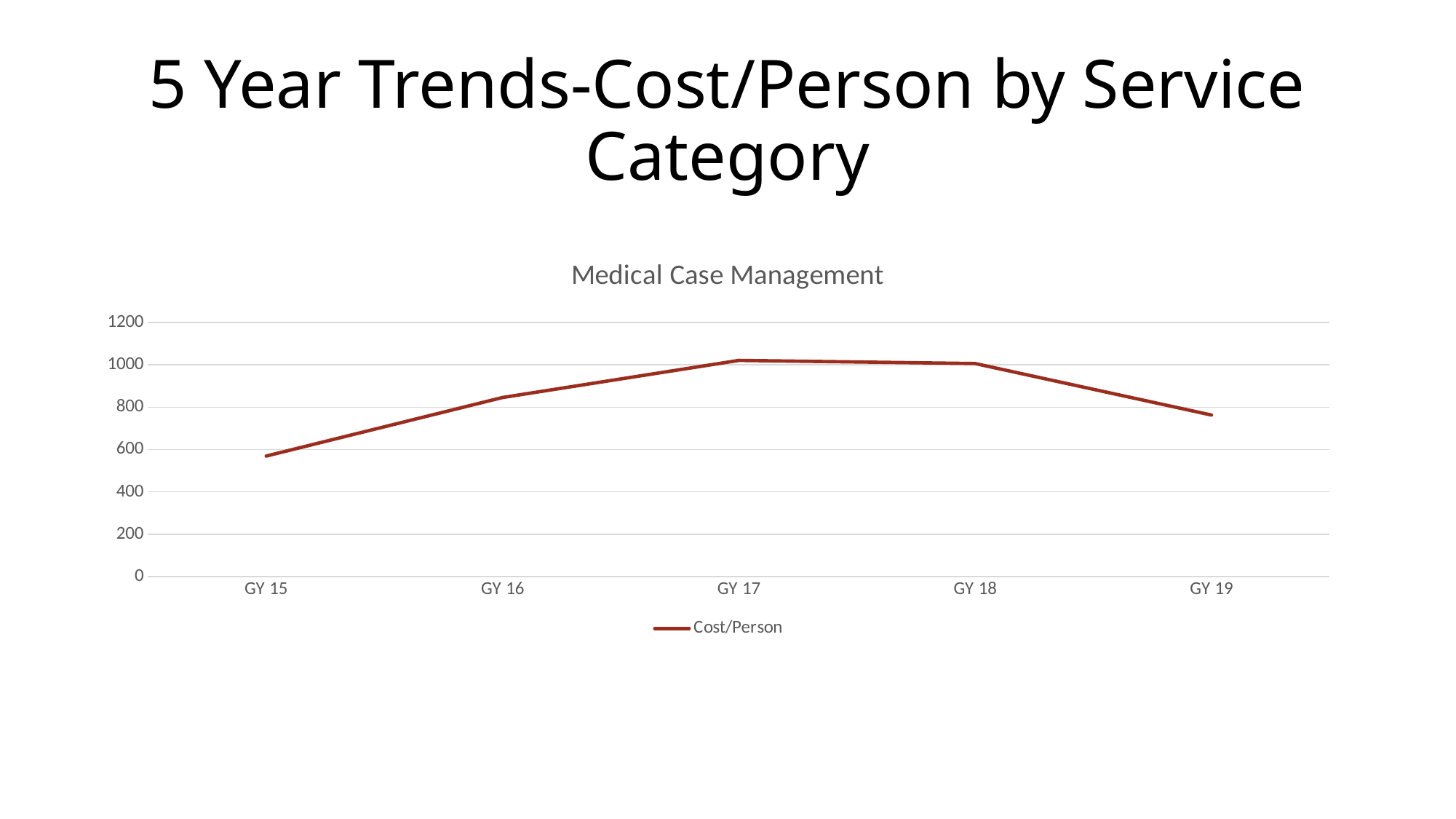
Which is larger, the Cost/Person for GY 16 or for GY 19? GY 16 What kind of chart is shown on the slide? Line chart Does the Cost/Person rise or fall from GY 18 to GY 19? Fall How many grant years are plotted on the x axis? 5 How many series does the legend list? 1 Is the Cost/Person for GY 16 greater or less than 800? greater What series name does the legend show? Cost/Person Is the Cost/Person for GY 15 greater or less than 600? less Which grant year has the lowest Cost/Person? GY 15 Does the Cost/Person rise or fall from GY 15 to GY 17? Rise Is the Cost/Person for GY 19 greater or less than 800? less What is the title of the chart? Medical Case Management